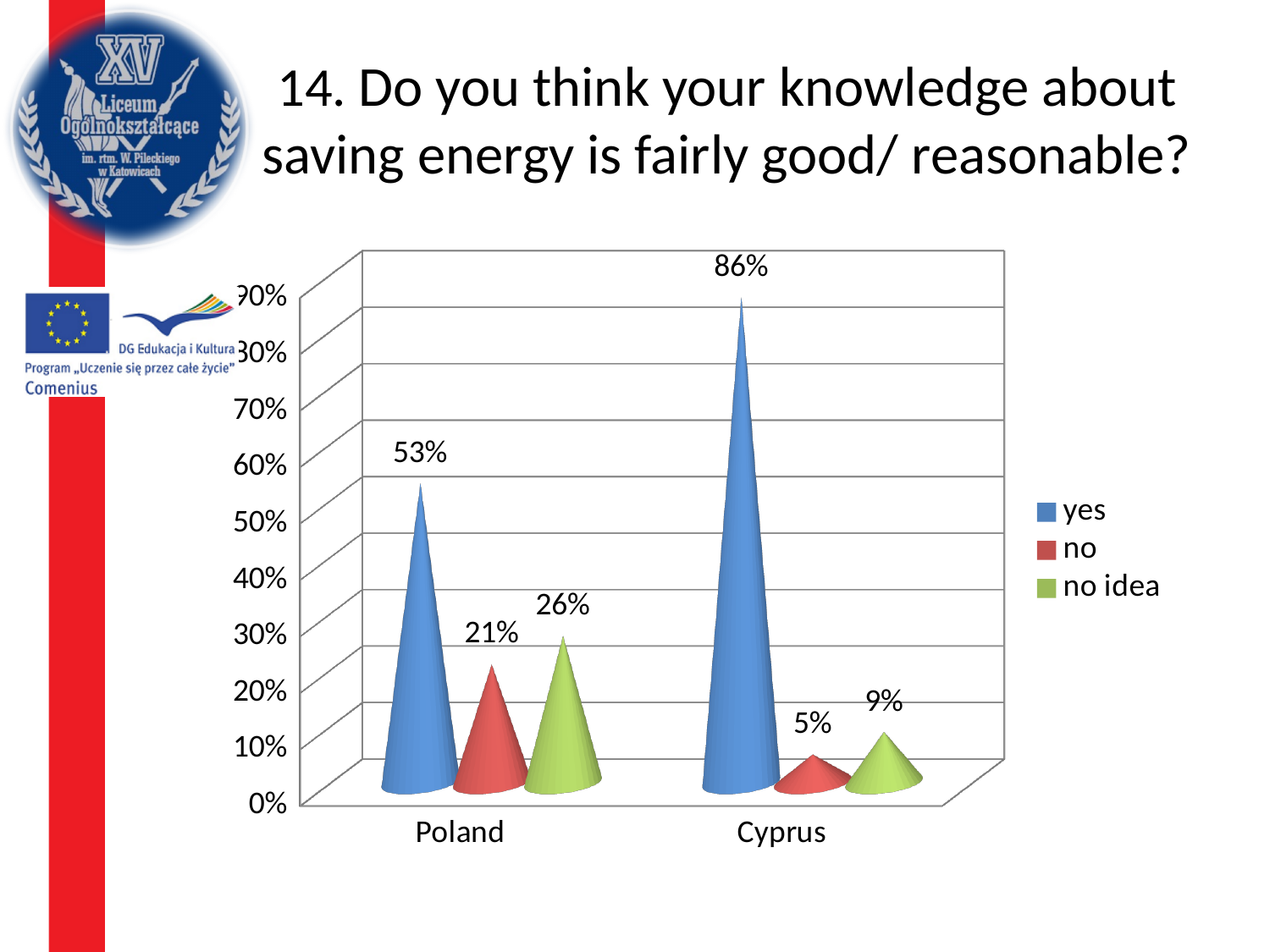
What is the difference between the "yes" values for Cyprus and Poland? 33% How many countries are shown on the x axis? 2 Which response has the lowest value for Cyprus? no How many series does the legend list? 3 Which response has the highest value for Poland? yes Which country has the higher "yes" value? Cyprus What is the value for "no idea" in Poland? 26% What is the difference between the "no idea" values for Poland and Cyprus? 17% What is the value for "yes" in Cyprus? 86% Which colour represents the "no idea" series? Green What percentage of respondents in Cyprus answered "no"? 5% What percentage of respondents in Poland answered "yes"? 53%